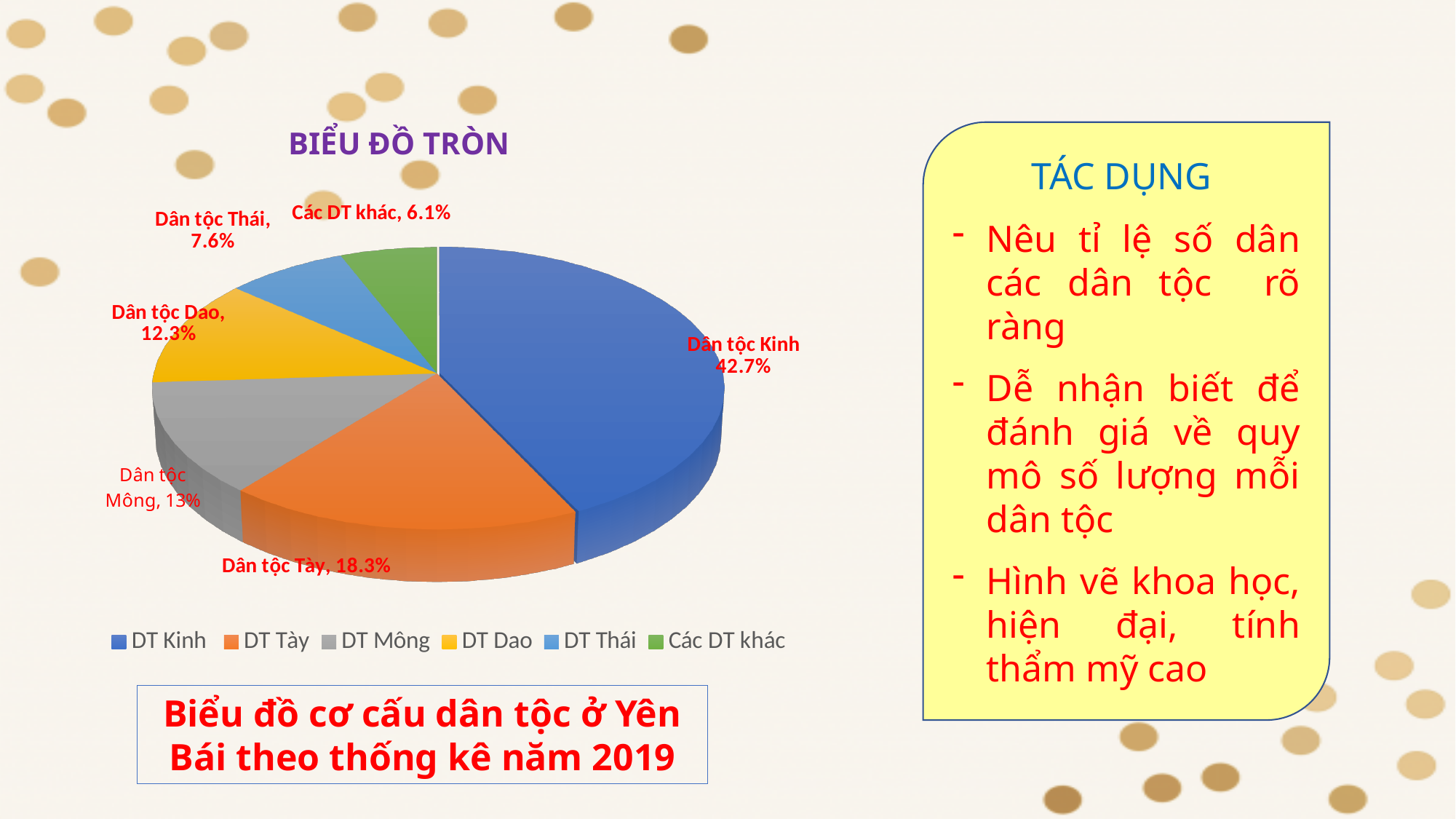
What is the value for Dân tộc Kinh in the pie chart? 42.7% Which category has the largest slice in the pie chart? Dân tộc Kinh What is the value for Dân tộc Tày in the pie chart? 18.3% How many categories does the legend of the pie chart list? 6 What is the title shown above the pie chart? BIỂU ĐỒ TRÒN What is the difference between the values for Dân tộc Kinh and Dân tộc Tày? 24.4% Which is larger, the value for Dân tộc Dao or Dân tộc Thái? Dân tộc Dao Which category has the smallest slice in the pie chart? Các DT khác What is the value for Dân tộc Mông in the pie chart? 13% What is the value for Các DT khác in the pie chart? 6.1% What is the value for Dân tộc Dao in the pie chart? 12.3% What type of chart is shown on the slide? Pie chart